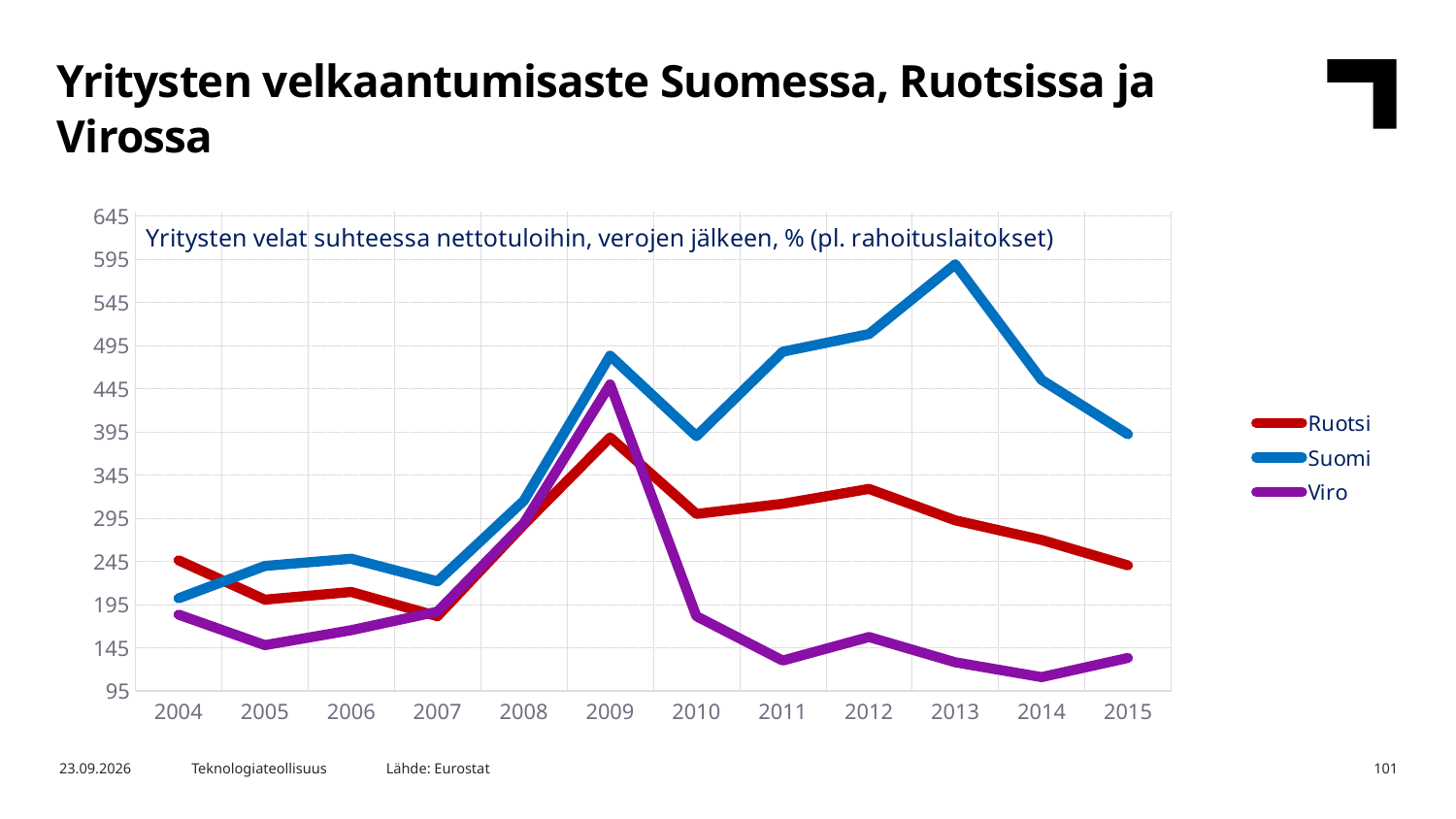
Does the Suomi line rise or fall from 2013 to 2015? fall In which year does the Viro line reach its lowest value? 2014 What is the subtitle text shown inside the chart area? Yritysten velat suhteessa nettotuloihin, verojen jälkeen, % (pl. rahoituslaitokset) Which series has the lowest value in 2015? Viro Is the value for Suomi in 2013 greater or less than 545? greater Which is larger in 2010, the value for Ruotsi or the value for Viro? Ruotsi How many years are shown on the x axis? 12 Is the value for Viro in 2014 greater or less than 145? less Is the value for Ruotsi in 2009 greater or less than 345? greater What kind of chart is shown on the slide? line chart In which year does the Suomi line reach its highest value? 2013 How many series does the legend list? 3